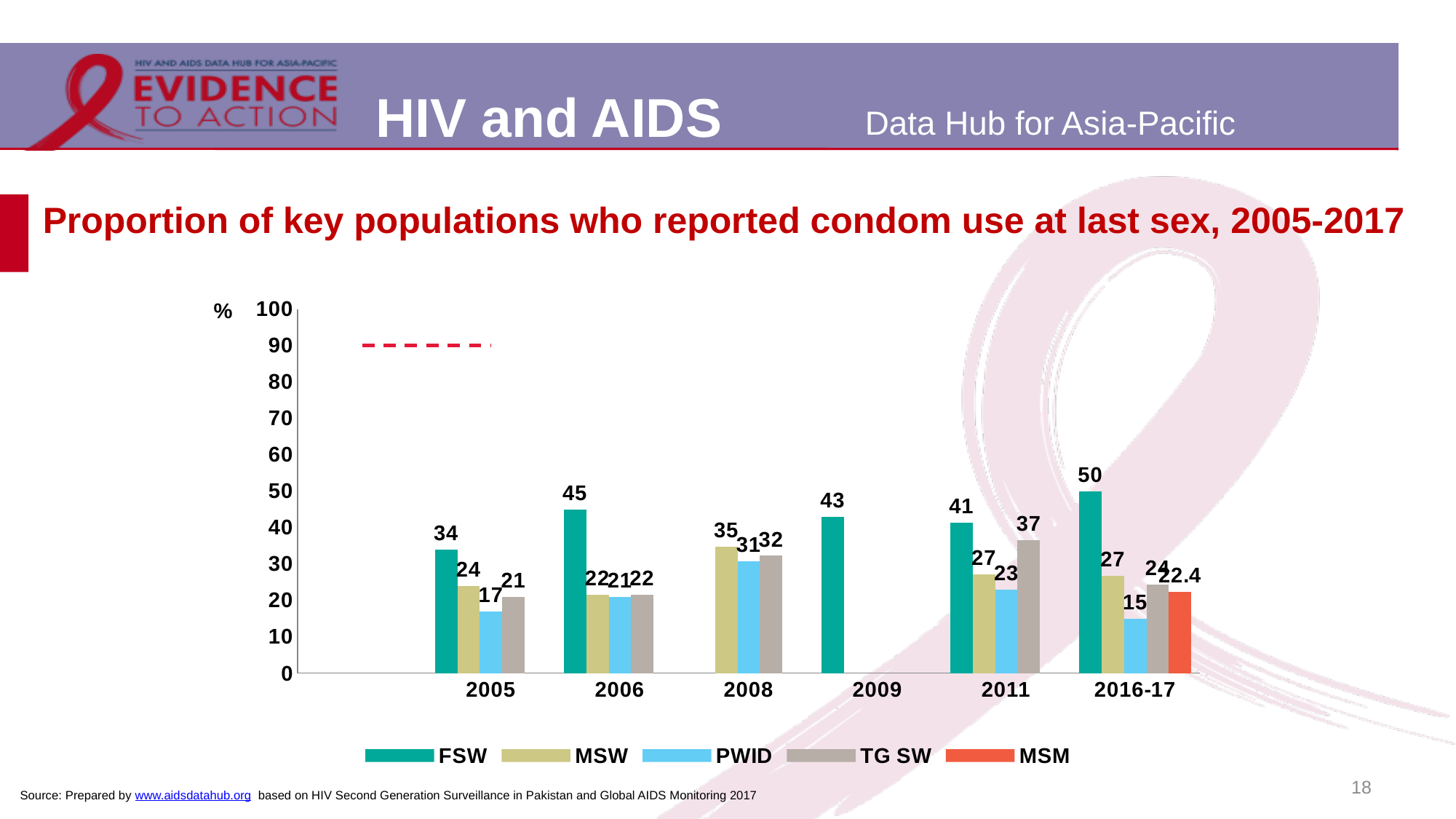
Do the PWID values rise or fall from 2005 to 2008? rise What is the value for FSW in 2016-17? 50 In 2011, which is larger: the TG SW value or the MSW value? TG SW What kind of chart is shown on the slide? bar chart What is the difference between the FSW value in 2016-17 and the FSW value in 2005? 16 What is the value for TG SW in 2011? 37 What is the value for MSM in 2016-17? 22.4 In which year is the PWID value lowest? 2016-17 How many year categories are shown on the x axis? 6 In which year is the FSW value highest? 2016-17 How many series does the legend list? 5 What is the value for PWID in 2005? 17